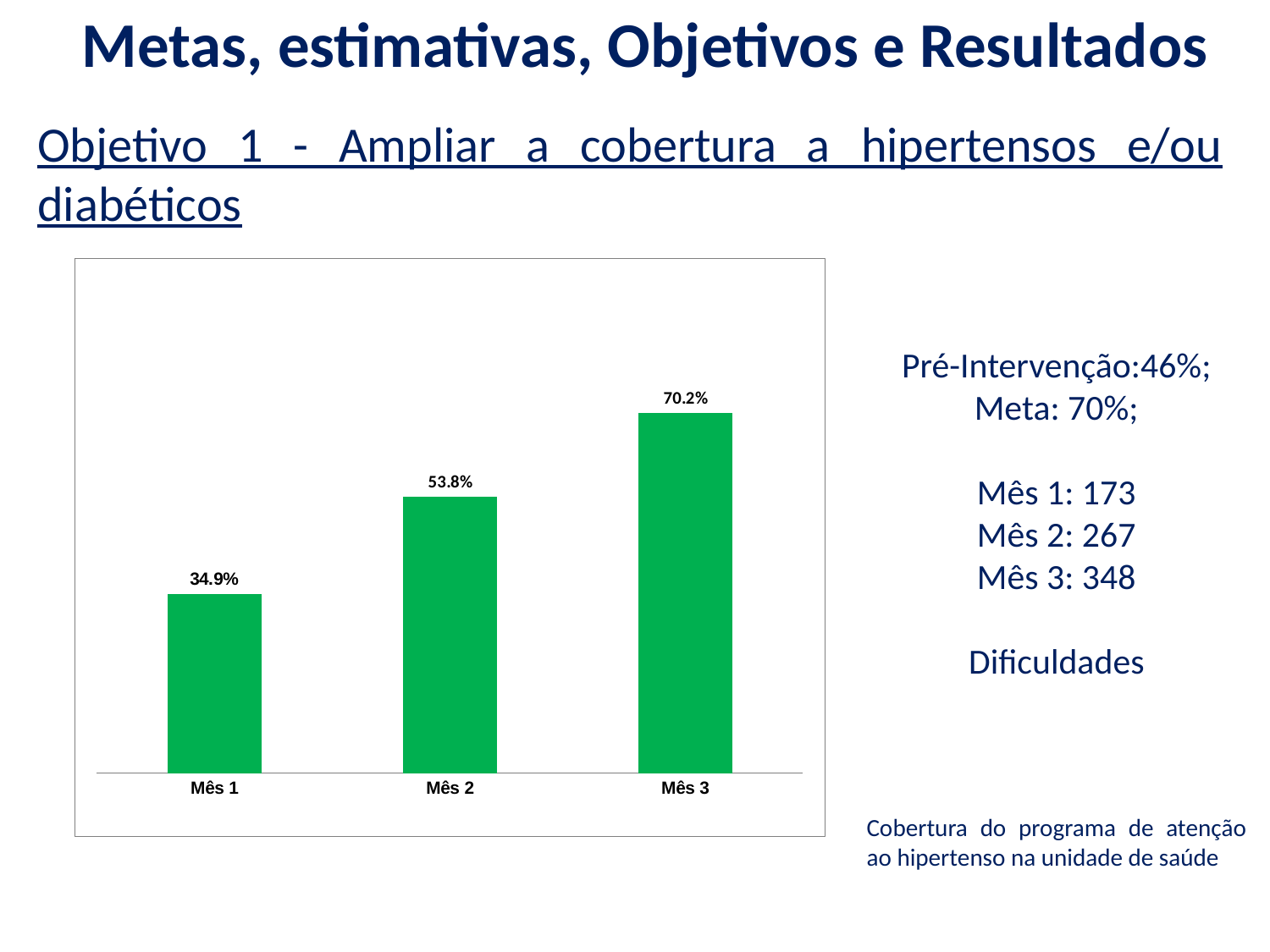
Which is larger, the value for Mês 2 or the value for Mês 3? Mês 3 Which category has the lowest value? Mês 1 What is the value for Mês 1? 34.9% What is the difference between the values for Mês 3 and Mês 1? 35.3% What is the difference between the values for Mês 2 and Mês 1? 18.9% Do the values rise or fall from Mês 1 to Mês 3? Rise What colour are the bars in the chart? Green What is the value for Mês 3? 70.2% What kind of chart is shown on the slide? Bar chart Which category has the highest value? Mês 3 What is the value for Mês 2? 53.8% How many categories are shown on the x axis? 3